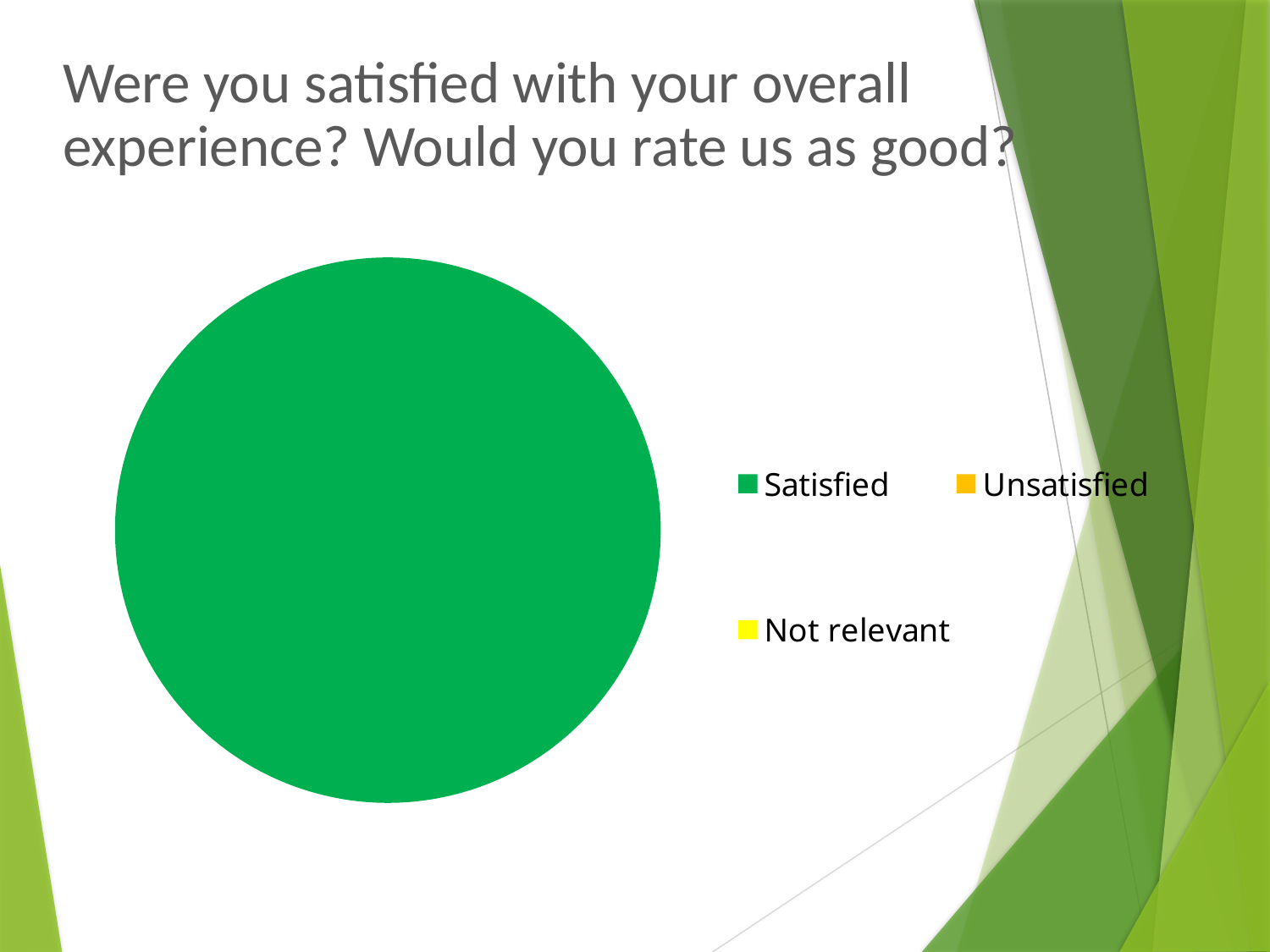
What colour represents the Satisfied category in the pie chart? Green Which legend entry is shown in yellow? Not relevant How many categories does the legend of the pie chart list? 3 Which category takes up the largest share of the pie chart? Satisfied What kind of chart is shown on the slide? Pie chart Which is larger in the pie chart, the Satisfied slice or the Not relevant slice? Satisfied Which is larger in the pie chart, the Satisfied slice or the Unsatisfied slice? Satisfied Which category is visible as a slice in the pie chart? Satisfied